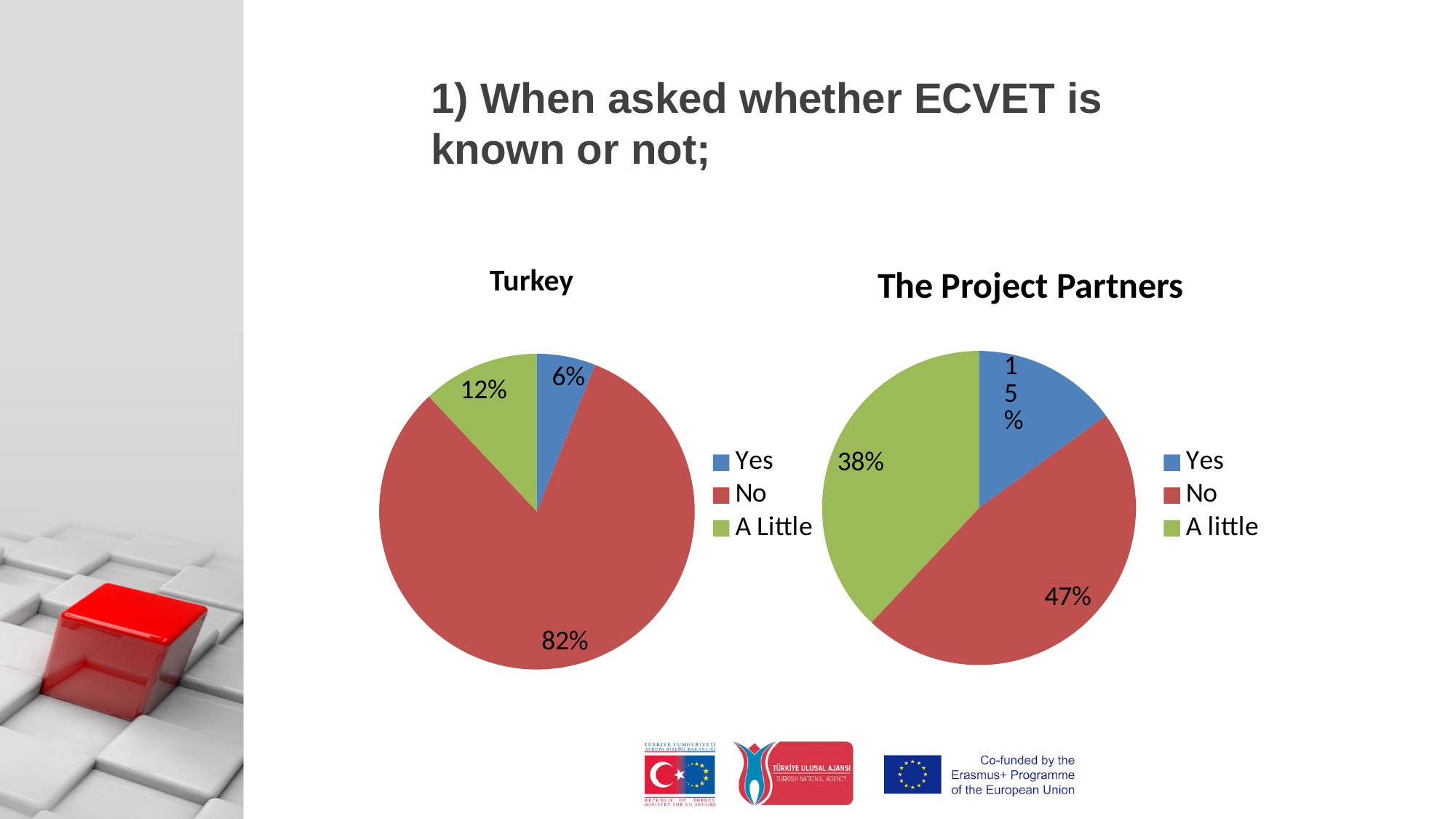
In the Turkey chart, what percentage answered A Little? 12% In The Project Partners chart, which response has the smallest share? Yes In The Project Partners chart, what percentage answered No? 47% What is the difference between the No share in the Turkey chart and the No share in The Project Partners chart? 35% In The Project Partners chart, what percentage answered Yes? 15% What type of chart is the Turkey chart? Pie chart In the Turkey chart, which response has the largest share? No In the Turkey chart, which response has the smallest share? Yes Which is larger: the Yes share in the Turkey chart or the Yes share in The Project Partners chart? The Project Partners In The Project Partners chart, what percentage answered A little? 38% In the Turkey chart, what percentage answered No? 82% In the Turkey chart, what percentage answered Yes? 6%